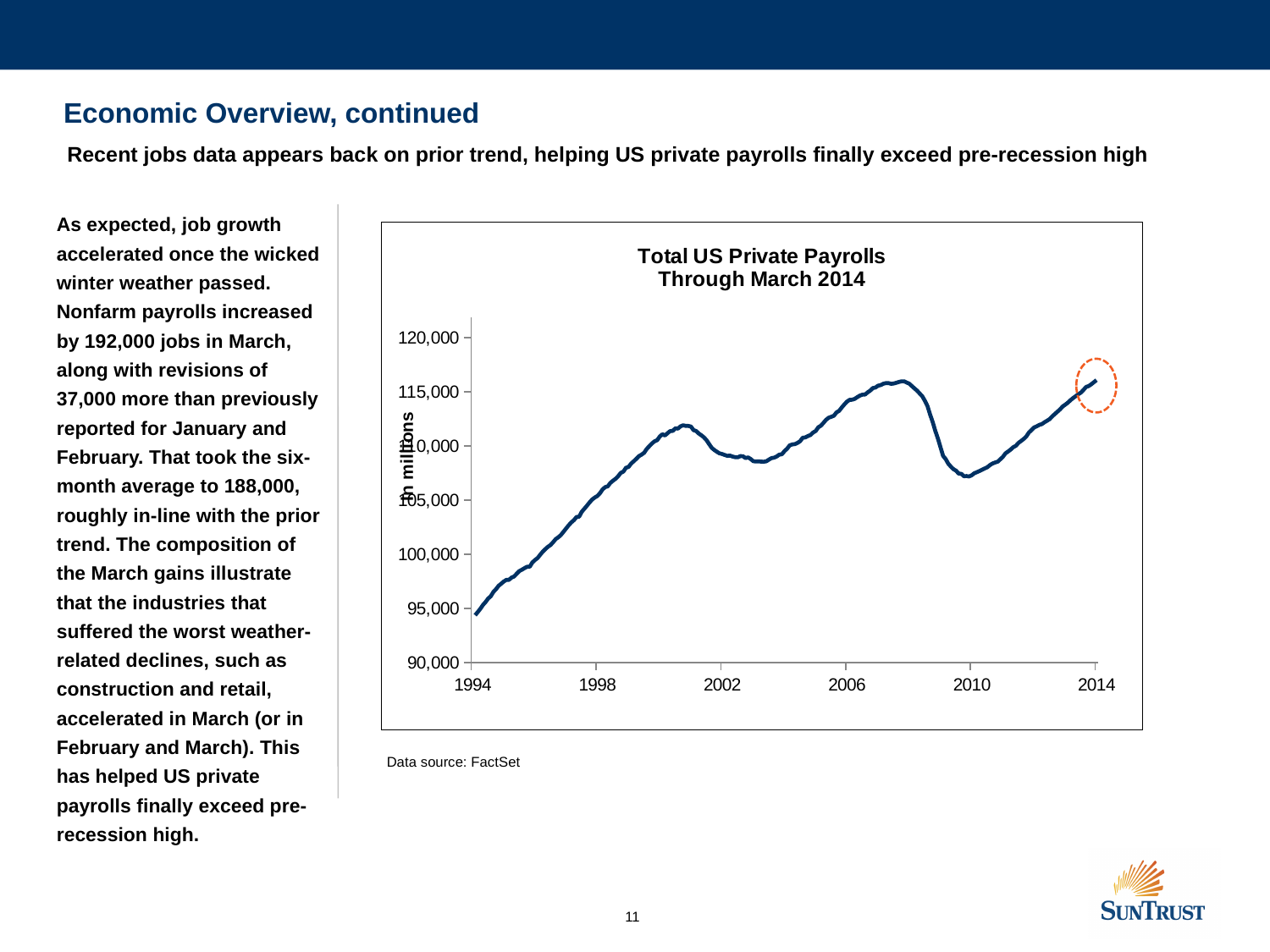
Is the value for 2010 greater or less than 110,000? less Does the line rise or fall between 2008 and 2009? Fall How many year labels are shown on the x axis? 6 Is the value for 2014 greater or less than 110,000? greater Is the value for 1994 greater or less than 100,000? less Does the line rise or fall from 2010 to 2014? Rise What is the data source cited below the chart? FactSet What kind of chart is shown on the slide? Line chart Does the line generally rise or fall from 1994 to 2014? Rise What is the title of the chart? Total US Private Payrolls Through March 2014